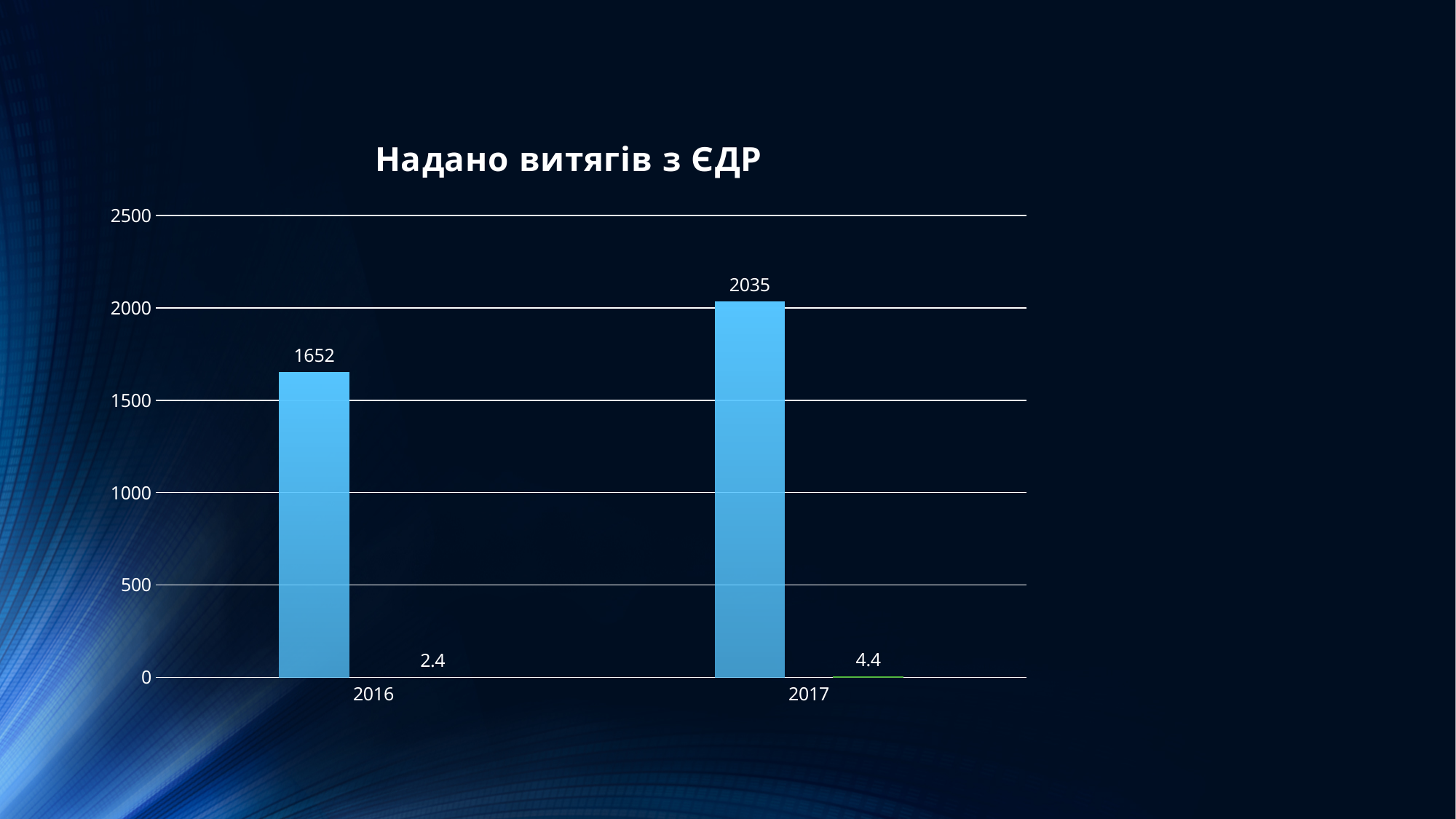
What is the title of the chart? Надано витягів з ЄДР How many years are shown on the x axis? 2 Which year has the taller blue bar? 2017 Do the blue bar values rise or fall from 2016 to 2017? rise By how much does the blue bar value for 2017 exceed that for 2016? 383 Which year has the shorter blue bar? 2016 Is the blue bar value for 2016 greater or less than 1500? greater What is the value of the blue bar for 2016? 1652 What is the smaller value labelled next to the 2017 bar? 4.4 What is the smaller value labelled next to the 2016 bar? 2.4 What is the value of the blue bar for 2017? 2035 What kind of chart is shown on the slide? bar chart